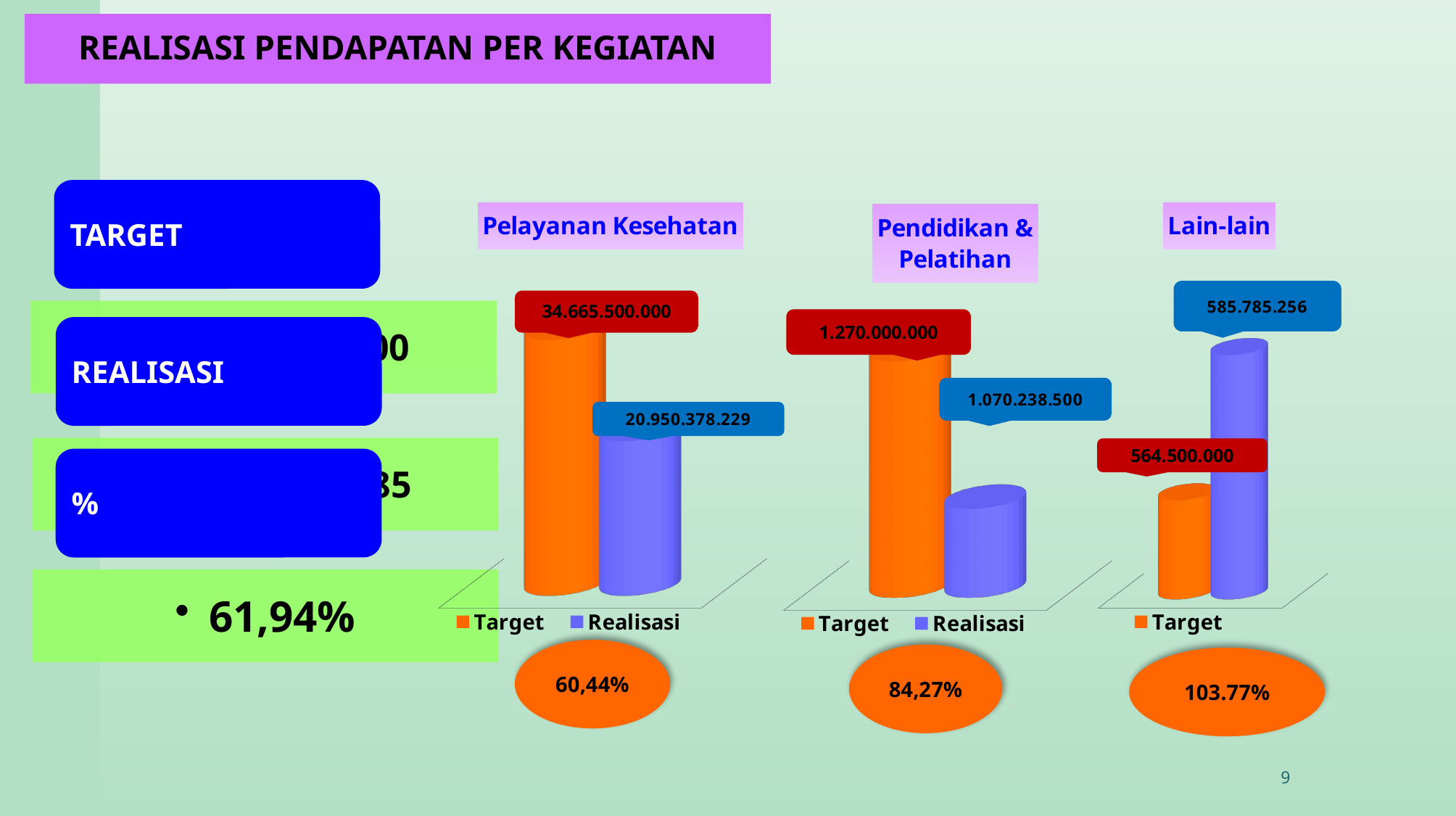
In the Pelayanan Kesehatan chart, what is the difference between Target and Realisasi? 13.715.121.771 In the Pelayanan Kesehatan chart, which is larger, Target or Realisasi? Target In the Lain-lain chart, what is the Realisasi value? 585.785.256 In the Lain-lain chart, what is the Target value? 564.500.000 In the Pendidikan & Pelatihan chart, what is the Target value? 1.270.000.000 In the Pendidikan & Pelatihan chart, what is the Realisasi value? 1.070.238.500 In the Pelayanan Kesehatan chart, what is the Realisasi value? 20.950.378.229 In the Pendidikan & Pelatihan chart, what is the difference between Target and Realisasi? 199.761.500 In the Pelayanan Kesehatan chart, what is the Target value? 34.665.500.000 How many series does the legend of the Pelayanan Kesehatan chart list? 2 In the Lain-lain chart, which is larger, Target or Realisasi? Realisasi What kind of chart is the Pendidikan & Pelatihan chart? Bar chart